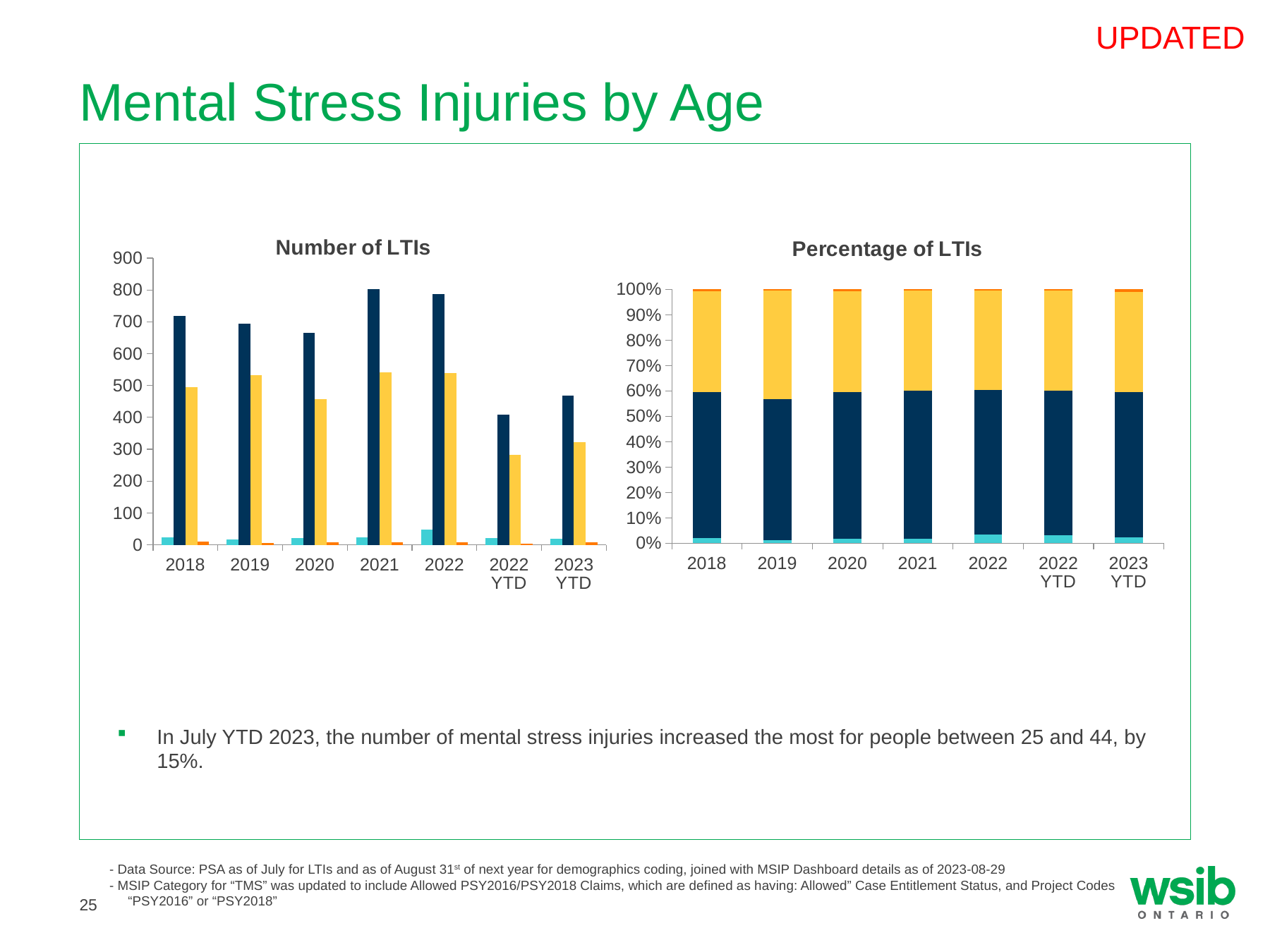
In the "Percentage of LTIs" chart, is the dark navy segment for 2018 greater or less than 50%? greater In the "Number of LTIs" chart, do the dark navy bars rise or fall from 2018 to 2020? fall In the "Number of LTIs" chart, is the yellow bar larger for 2019 or 2020? 2019 What kind of chart is the "Number of LTIs" chart? Bar chart In the "Number of LTIs" chart, is the dark navy bar larger for 2022 YTD or 2023 YTD? 2023 YTD In the "Number of LTIs" chart, is the dark navy bar for 2018 greater or less than 600? greater How many year categories are shown on the x axis of the "Number of LTIs" chart? 7 In the "Number of LTIs" chart, which category has the lowest dark navy bar? 2022 YTD In the "Number of LTIs" chart, is the dark navy bar for 2022 YTD greater or less than 500? less In the "Number of LTIs" chart, which category has the lowest yellow bar? 2022 YTD What kind of chart is the "Percentage of LTIs" chart? Stacked bar chart